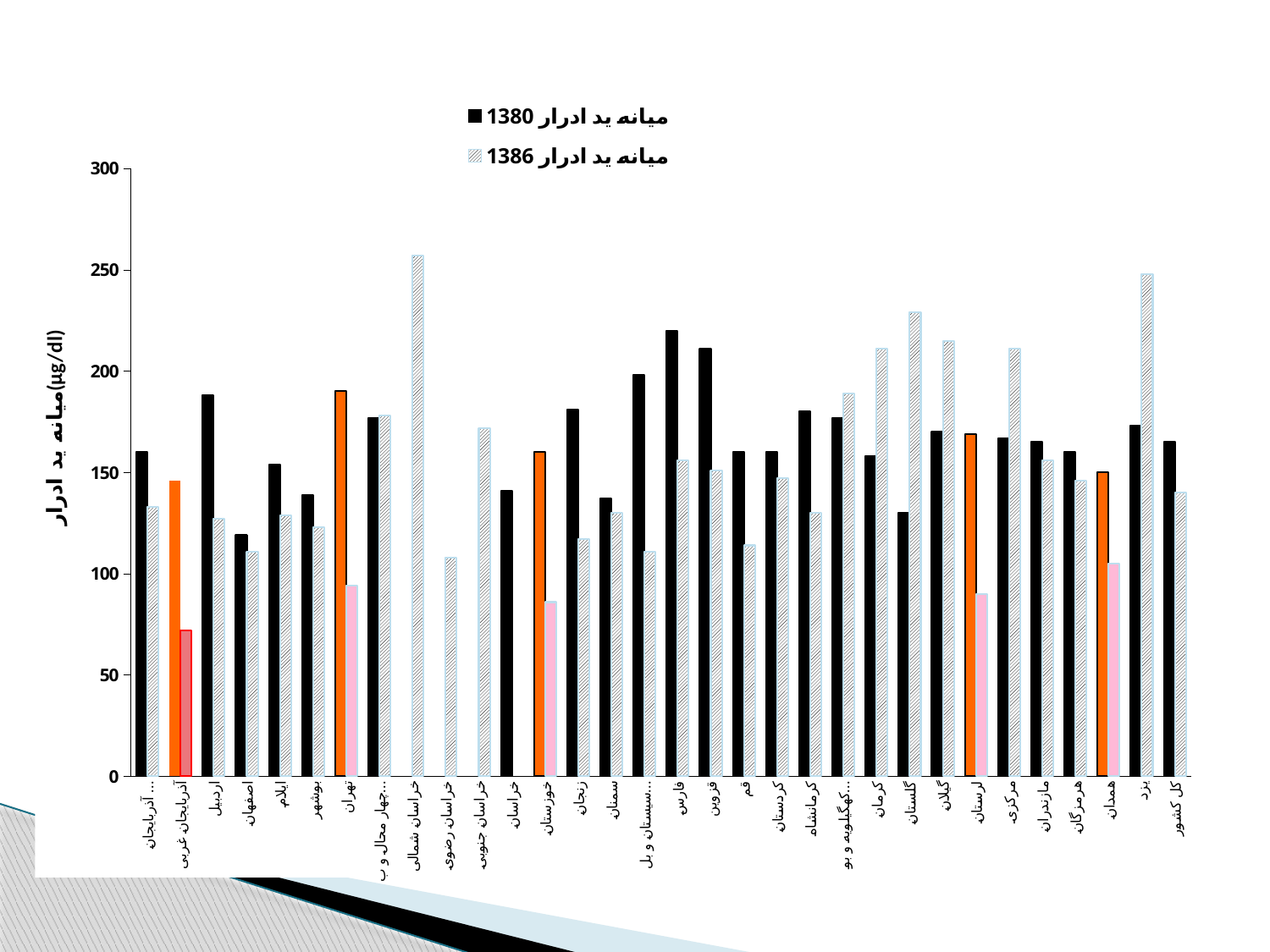
What is the title of the y axis? میانه ید ادرار (µg/dl) How many series does the legend list? 2 Is the value for خراسان شمالی in the series میانه ید ادرار 1386 greater or less than 250? greater How many categories are shown along the x axis? 32 Which category has the lowest value for the series میانه ید ادرار 1386? آذربایجان غربی For تهران, which series has the larger value: میانه ید ادرار 1380 or میانه ید ادرار 1386? میانه ید ادرار 1380 Is the value for یزد in the series میانه ید ادرار 1386 greater or less than 200? greater Is the value for کل کشور in the series میانه ید ادرار 1380 greater or less than 150? greater What kind of chart is shown on the slide? bar chart Which category has the highest value for the series میانه ید ادرار 1386? خراسان شمالی